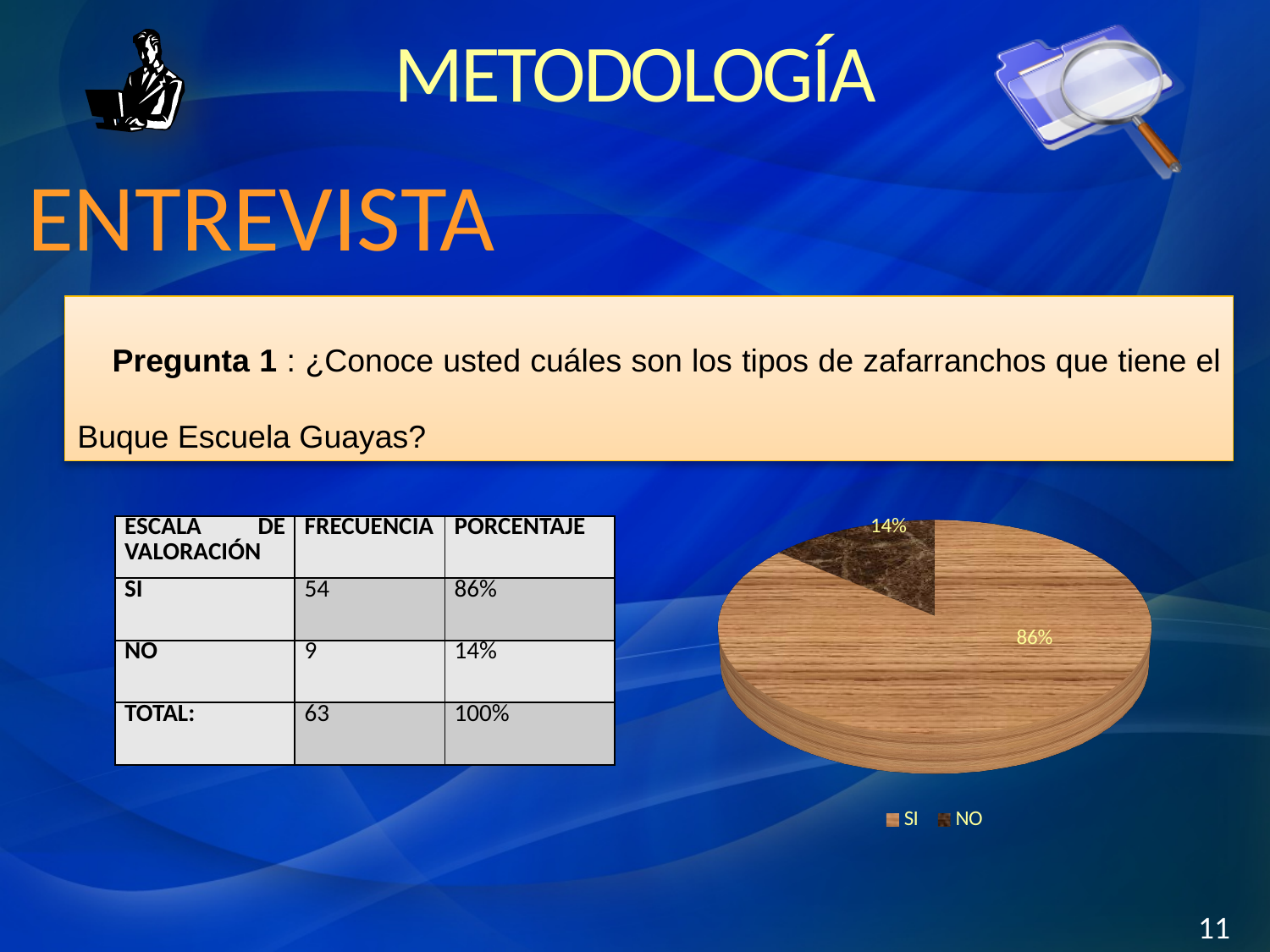
What is the share of the pie taken by the SI slice? 86% Which slice of the pie chart is the smallest? NO What percentage does the NO slice of the pie chart represent? 14% How many slices does the pie chart have? 2 How many entries does the legend of the pie chart list? 2 What percentage does the SI slice of the pie chart represent? 86% Which is larger in the pie chart, SI or NO? SI What is the difference in percentage points between the SI and NO slices? 72 What are the legend entries of the pie chart? SI, NO What kind of chart is shown on the slide? pie chart Which slice of the pie chart is the largest? SI